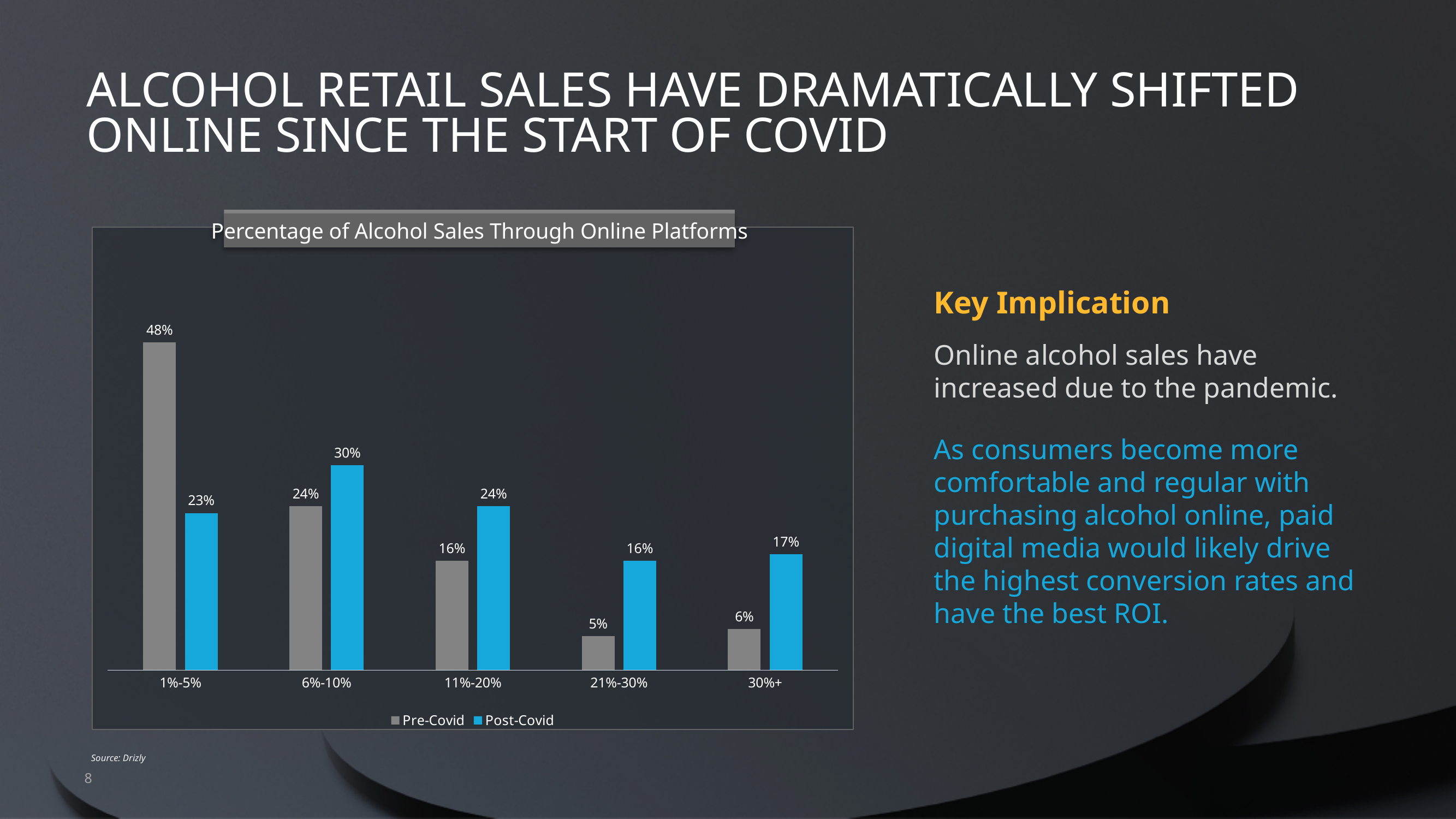
Which category has the lowest Pre-Covid value? 21%-30% What is the Post-Covid value for the 30%+ category? 17% What is the difference between the Pre-Covid and Post-Covid values for the 1%-5% category? 25% How many series does the legend list? 2 Which category has the highest Post-Covid value? 6%-10% Which category has the highest Pre-Covid value? 1%-5% How many categories are shown on the x axis? 5 What is the Pre-Covid value for the 1%-5% category? 48% What is the difference between the Post-Covid and Pre-Covid values for the 21%-30% category? 11% What is the Post-Covid value for the 6%-10% category? 30% What type of chart is shown on the slide? Bar chart For the 11%-20% category, which is larger: the Pre-Covid or the Post-Covid value? Post-Covid